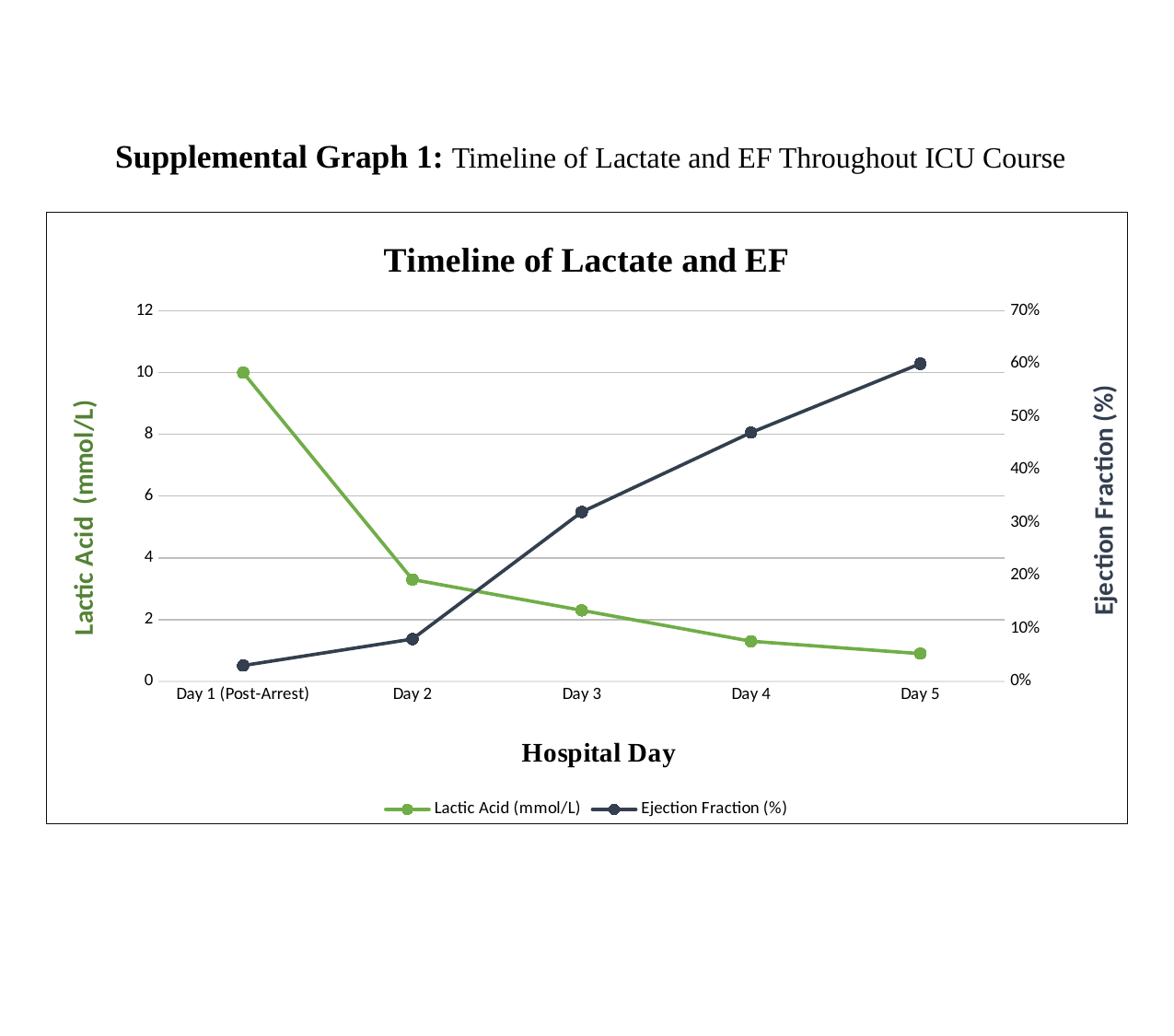
Does Lactic Acid (mmol/L) rise or fall from Day 1 to Day 5? fall Is the Lactic Acid (mmol/L) value on Day 2 greater or less than 4? less What is the title of the chart? Timeline of Lactate and EF How many series does the legend list? 2 What kind of chart is shown on the slide? line chart Does Ejection Fraction (%) rise or fall from Day 1 to Day 5? rise On which hospital day is Ejection Fraction (%) highest? Day 5 On which hospital day is Lactic Acid (mmol/L) highest? Day 1 (Post-Arrest) What is the Lactic Acid (mmol/L) value on Day 1 (Post-Arrest)? 10 On which hospital day is Ejection Fraction (%) lowest? Day 1 (Post-Arrest) Is the Ejection Fraction (%) value on Day 4 greater or less than 40%? greater How many hospital days are plotted along the x axis? 5